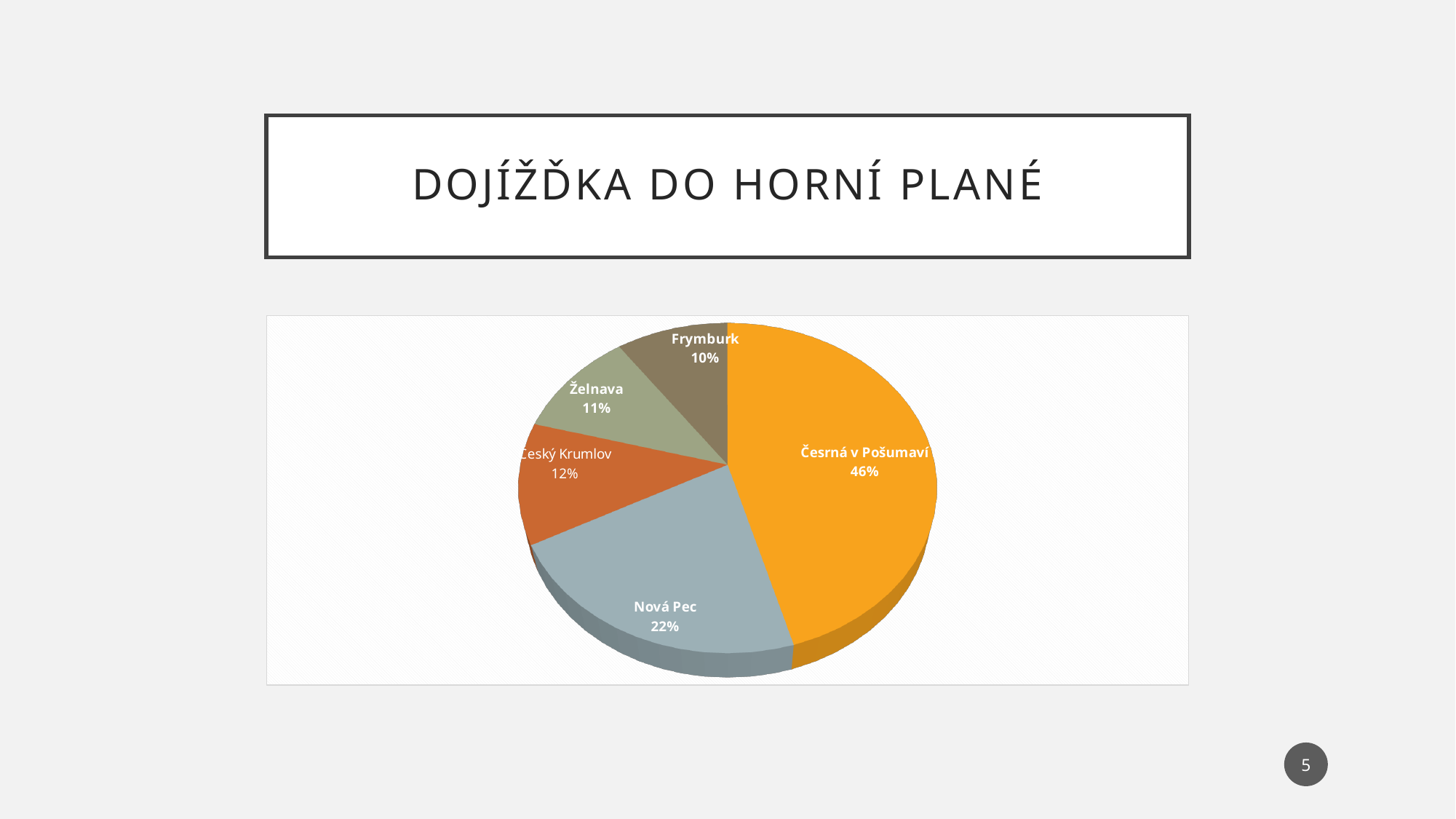
What is the value shown for Český Krumlov? 12% What kind of chart is shown on the slide? Pie chart What is the difference in percentage points between Česrná v Pošumaví and Nová Pec? 24 Which is larger, the slice for Nová Pec or the slice for Český Krumlov? Nová Pec What is the value shown for Frymburk? 10% What is the value shown for Želnava? 11% What is the title of the slide containing the chart? DOJÍŽĎKA DO HORNÍ PLANÉ Which category has the smallest slice of the pie? Frymburk Which category has the largest slice of the pie? Česrná v Pošumaví How many slices does the pie chart have? 5 What is the value shown for Nová Pec? 22% What share of the pie does Česrná v Pošumaví have? 46%